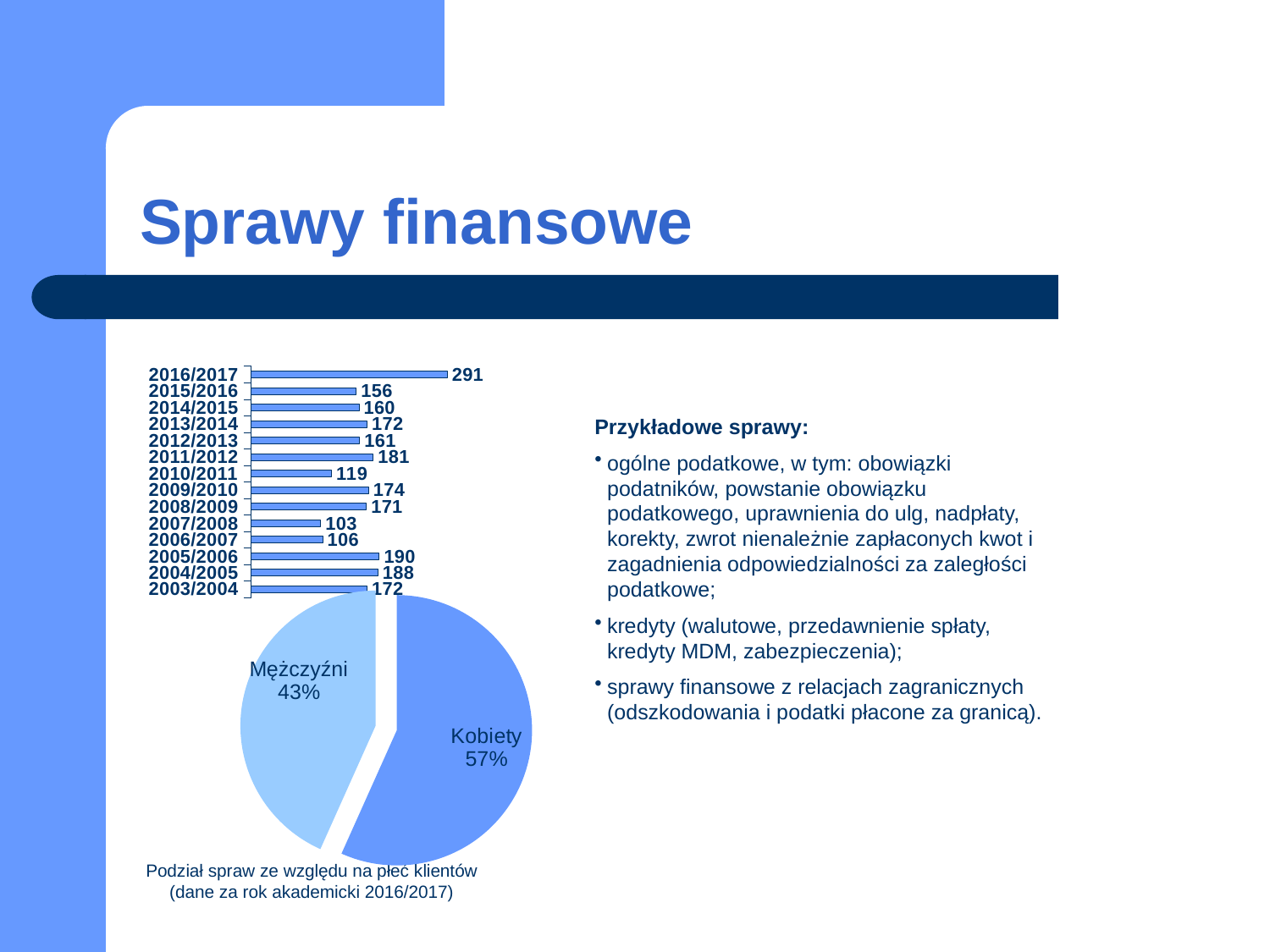
In the bar chart, which academic year has the lowest value? 2007/2008 How many academic years are shown in the bar chart? 14 In the bar chart, what is the difference between the values for 2016/2017 and 2015/2016? 135 In the bar chart, what is the value for 2016/2017? 291 In the bar chart, which academic year has the highest value? 2016/2017 In the bar chart, what is the value for 2005/2006? 190 In the pie chart, what share is labelled Mężczyźni? 43% In the bar chart, what is the value for 2010/2011? 119 In the pie chart, what share is labelled Kobiety? 57% What type of chart is the upper chart on the slide? bar chart What type of chart is the lower chart on the slide? pie chart In the bar chart, which is larger: the value for 2011/2012 or the value for 2012/2013? 2011/2012